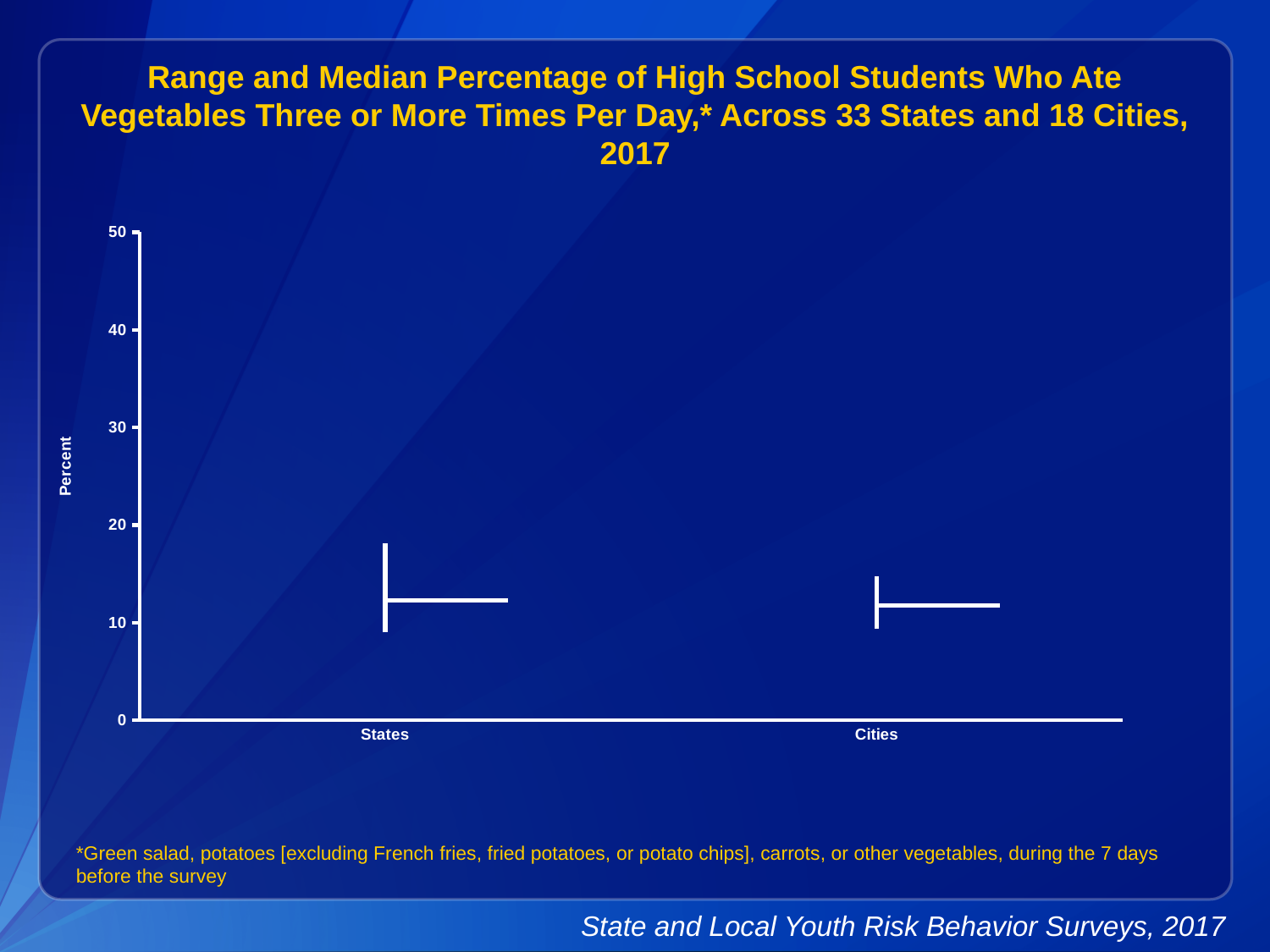
Which category has the higher top of its range, States or Cities? States Is the bottom of the range for States greater or less than 20? less What are the two categories shown on the x axis? States and Cities What is the highest value shown on the y axis? 50 What is the label on the y axis of the chart? Percent Is the median value for States greater or less than 20? less Is the median value for States greater or less than 30? less How many categories are shown on the x axis of the chart? 2